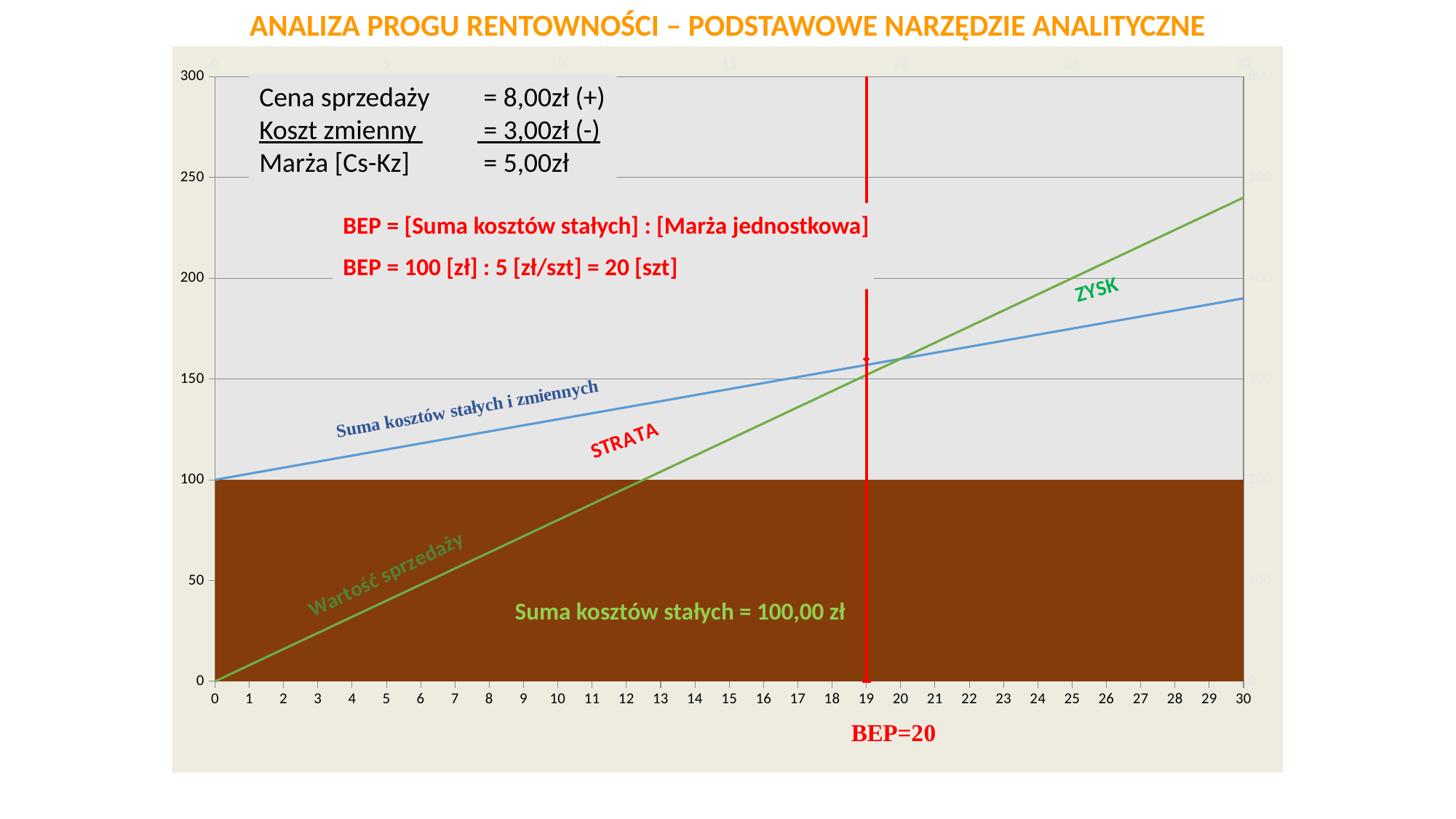
At what quantity does the chart mark the break-even point (BEP)? 20 What is the value of 'Suma kosztów stałych' shown on the chart? 100,00 zł Is the value of 'Suma kosztów stałych i zmiennych' at x = 30 greater or less than 200? less How many tick labels are shown on the x axis? 31 At x = 30, which line is higher: 'Wartość sprzedaży' or 'Suma kosztów stałych i zmiennych'? Wartość sprzedaży What label marks the region to the right of the BEP line where sales exceed costs? ZYSK What colour is the 'Wartość sprzedaży' line? green Does the 'Suma kosztów stałych i zmiennych' line rise or fall along the x axis? rise Is the value of 'Wartość sprzedaży' at x = 30 greater or less than 200? greater Does the 'Wartość sprzedaży' line rise or fall as the x axis increases? rise What type of chart is shown on the slide? combination area and line chart At x = 10, which line is higher: 'Wartość sprzedaży' or 'Suma kosztów stałych i zmiennych'? Suma kosztów stałych i zmiennych